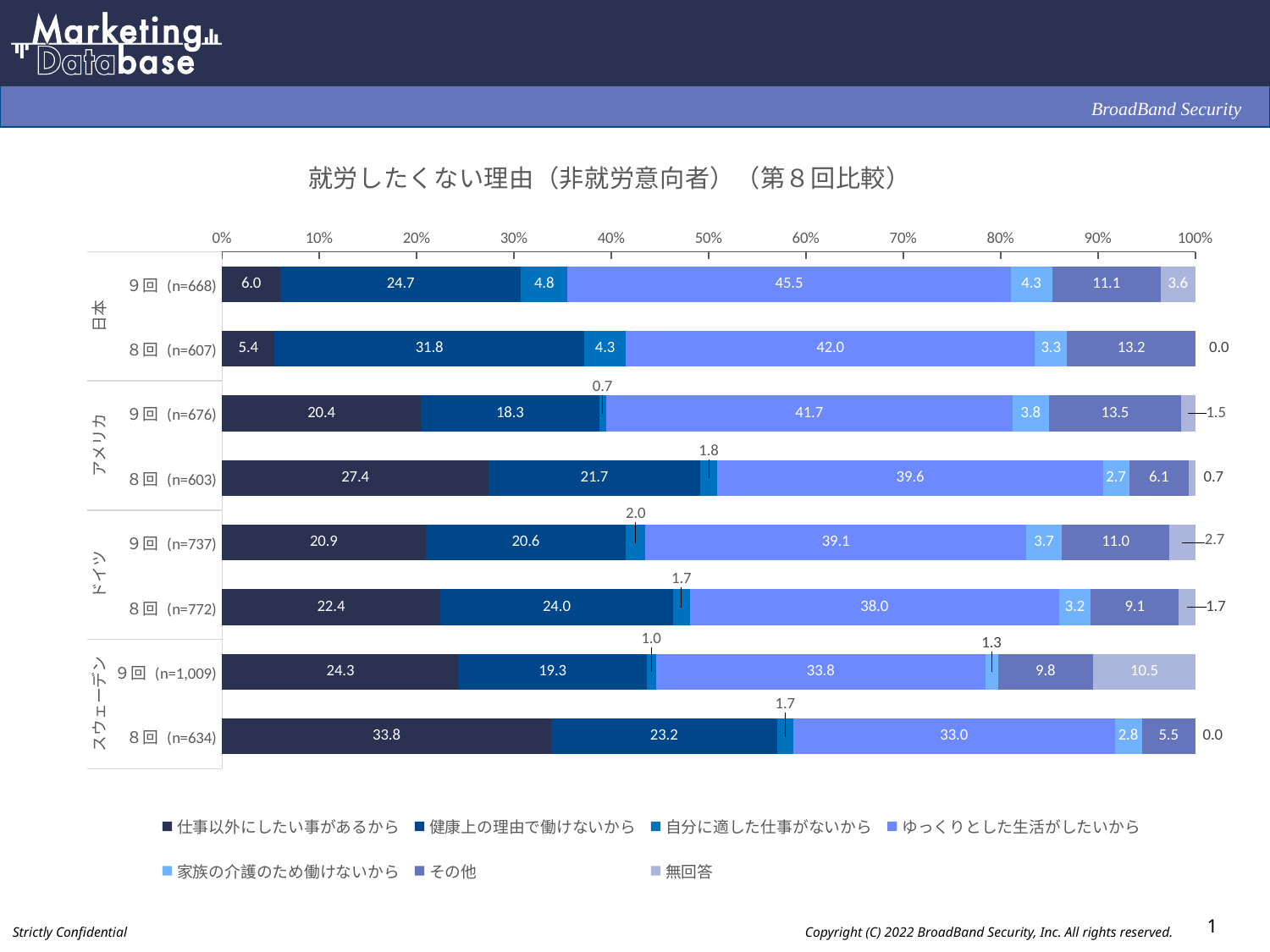
What is the value for ゆっくりとした生活がしたいから for 日本 9回 (n=668)? 45.5 What is the difference between the 健康上の理由で働けないから values for 日本 8回 (n=607) and 日本 9回 (n=668)? 7.1 How many bars are shown in the chart? 8 What kind of chart is shown on the slide? Stacked bar chart Which bar has the highest value for ゆっくりとした生活がしたいから? 日本 9回 (n=668) What is the title of the chart? 就労したくない理由（非就労意向者）（第８回比較） What is the value for 無回答 for スウェーデン 9回 (n=1,009)? 10.5 Which is larger for アメリカ 8回 (n=603): 仕事以外にしたい事があるから or 健康上の理由で働けないから? 仕事以外にしたい事があるから What is the value for 仕事以外にしたい事があるから for スウェーデン 8回 (n=634)? 33.8 How many series does the legend list? 7 What is the value for 健康上の理由で働けないから for 日本 8回 (n=607)? 31.8 Which bar has the lowest value for 仕事以外にしたい事があるから? 日本 8回 (n=607)